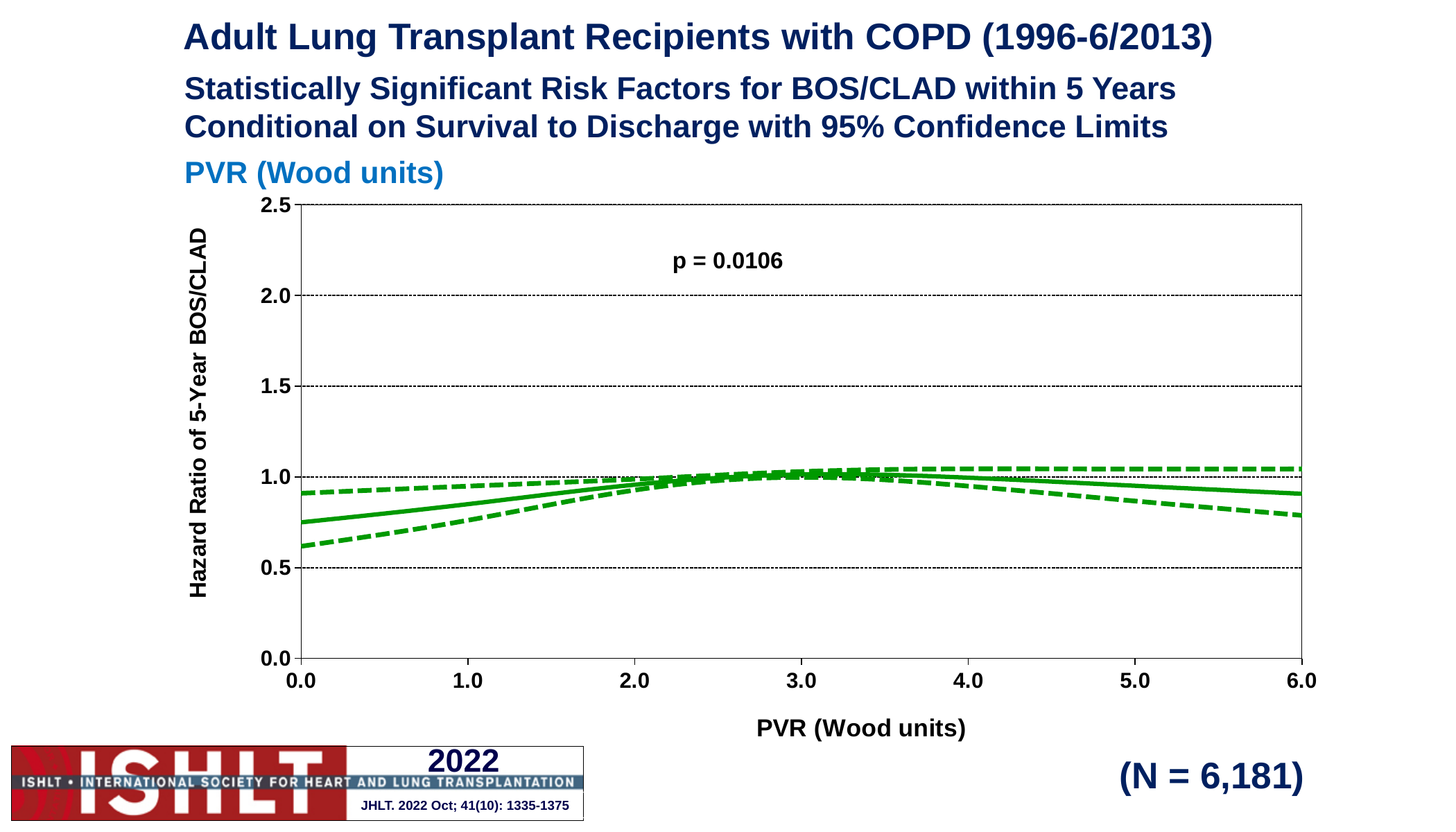
Is the hazard ratio on the solid line larger at a PVR of 0.0 or at a PVR of 6.0 Wood units? 6.0 Does the solid hazard ratio line rise or fall as PVR increases from 3.0 to 6.0 Wood units? fall Is the hazard ratio on the solid line at a PVR of 0.0 Wood units greater or less than 1.0? less Is the lower dashed confidence limit at a PVR of 6.0 Wood units greater or less than 1.0? less Is the lower dashed confidence limit at a PVR of 0.0 Wood units greater or less than 0.5? greater Does the solid hazard ratio line rise or fall as PVR increases from 0.0 to 3.0 Wood units? rise What p-value is printed on the chart? p = 0.0106 What is the label of the y-axis? Hazard Ratio of 5-Year BOS/CLAD How many lines are plotted on the chart? 3 What kind of chart is shown on the slide? line chart